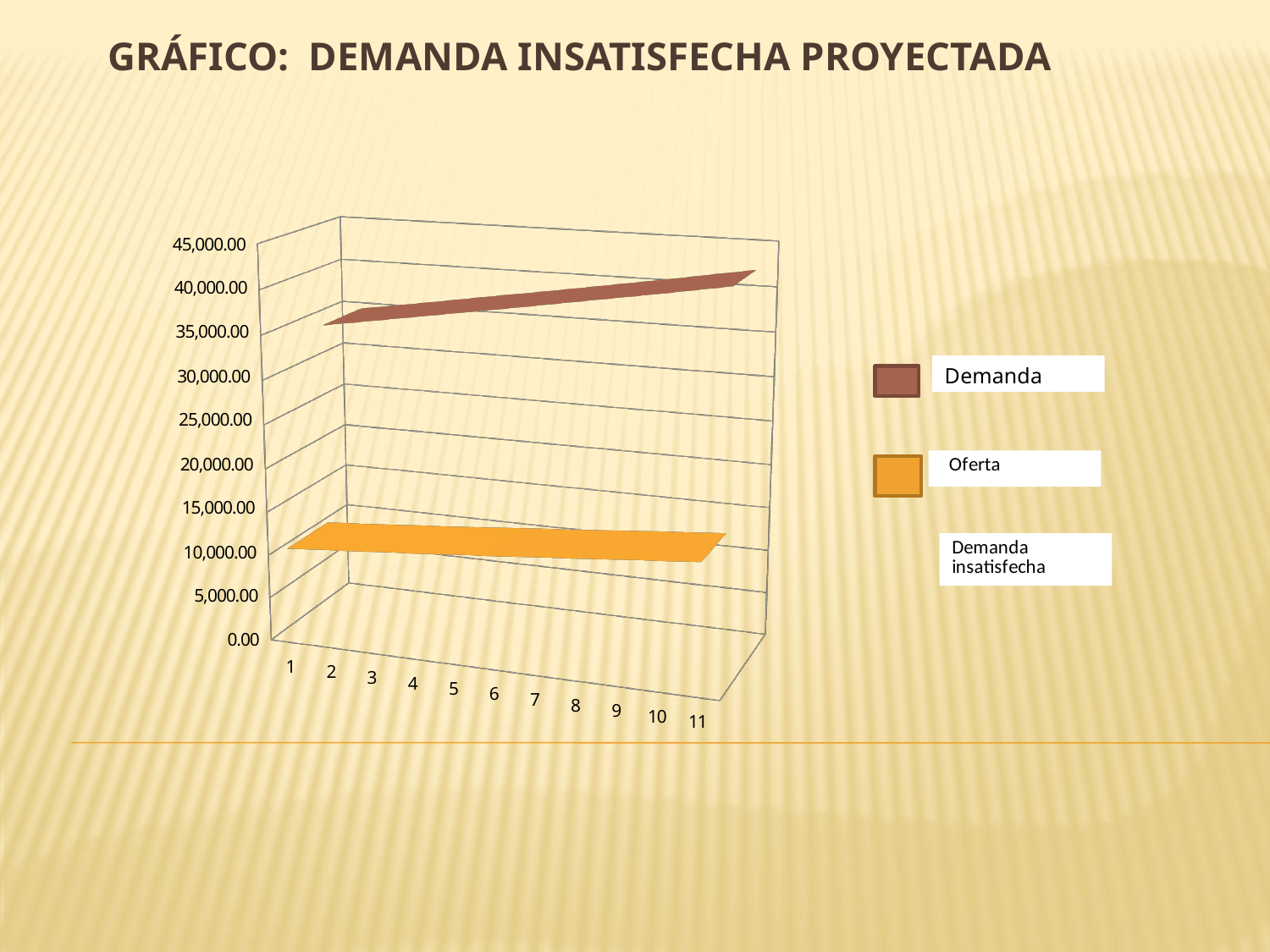
Is the value of Demanda at category 11 greater or less than 45,000.00? less Which series is plotted higher on the chart, Demanda or Oferta? Demanda What is the highest value labelled on the vertical axis of the chart? 45,000.00 How many categories are shown along the x axis of the chart? 11 Is the value of Oferta at category 1 greater or less than 5,000.00? greater Does the Demanda series rise or fall from category 1 to category 11? Rise Is the value of Demanda at category 1 greater or less than 25,000.00? greater What kind of chart is shown on the slide? Line chart (3D) What is the title of the chart on the slide? GRÁFICO: DEMANDA INSATISFECHA PROYECTADA What colour is used for the Oferta series in the chart? Orange